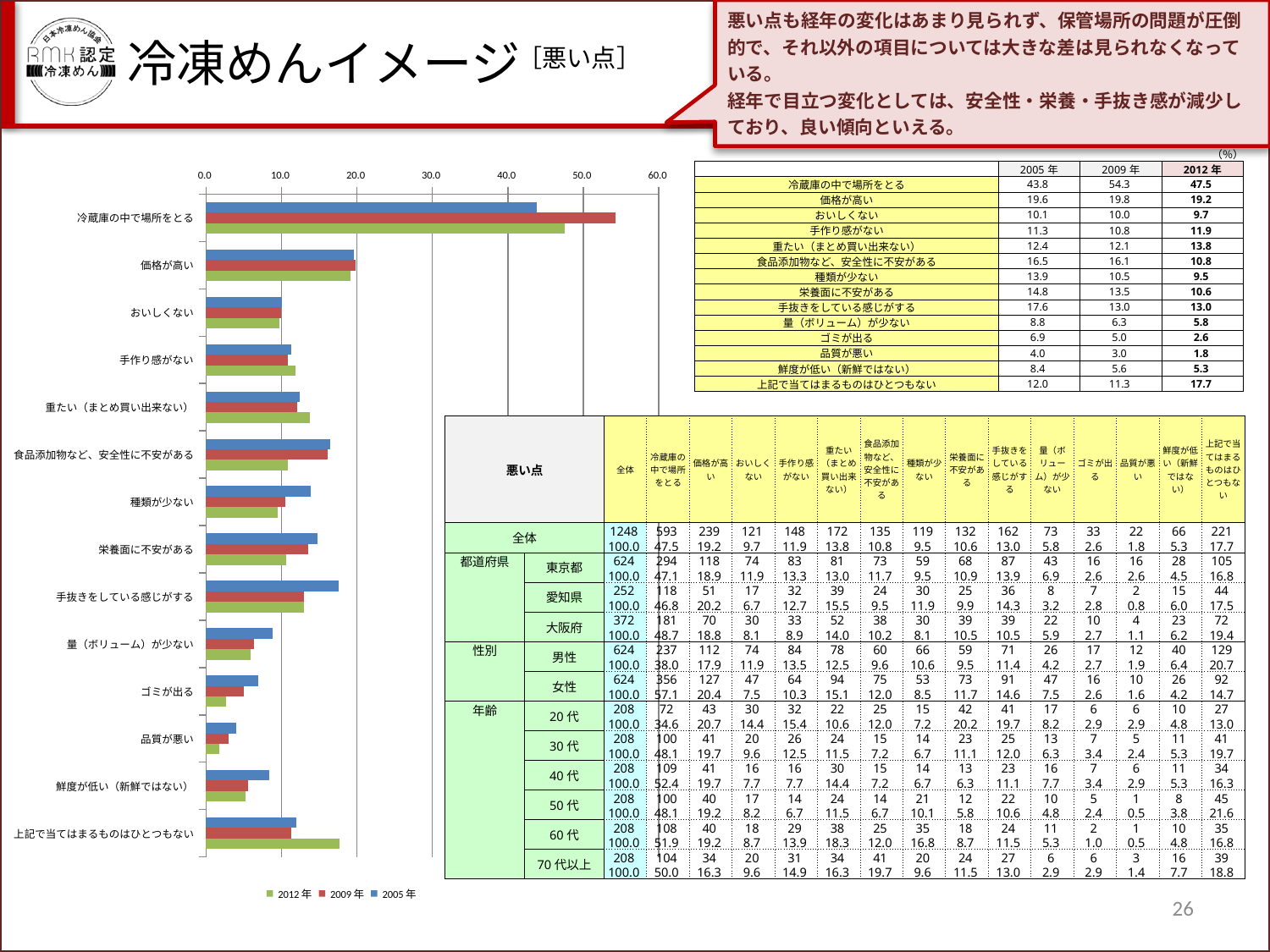
Which category has the highest value for 2009年 in the bar chart? 冷蔵庫の中で場所をとる How many categories are plotted on the bar chart? 14 What colour represents 2012年 in the bar chart legend? green Is the 2009年 value for 冷蔵庫の中で場所をとる greater or less than 50.0? greater Is the 2012年 value for 品質が悪い greater or less than 10.0? less Which category has the lowest 2012年 value? 品質が悪い What type of chart is shown on the left of the slide? bar chart What is the 2012年 value for 上記で当てはまるものはひとつもない? 17.7 What is the 2009年 value for 冷蔵庫の中で場所をとる? 54.3 How many series does the legend of the bar chart list? 3 What is the difference between the 2012年 and 2005年 values for 冷蔵庫の中で場所をとる? 3.7 For 手抜きをしている感じがする, which is larger, the 2005年 value or the 2012年 value? 2005年